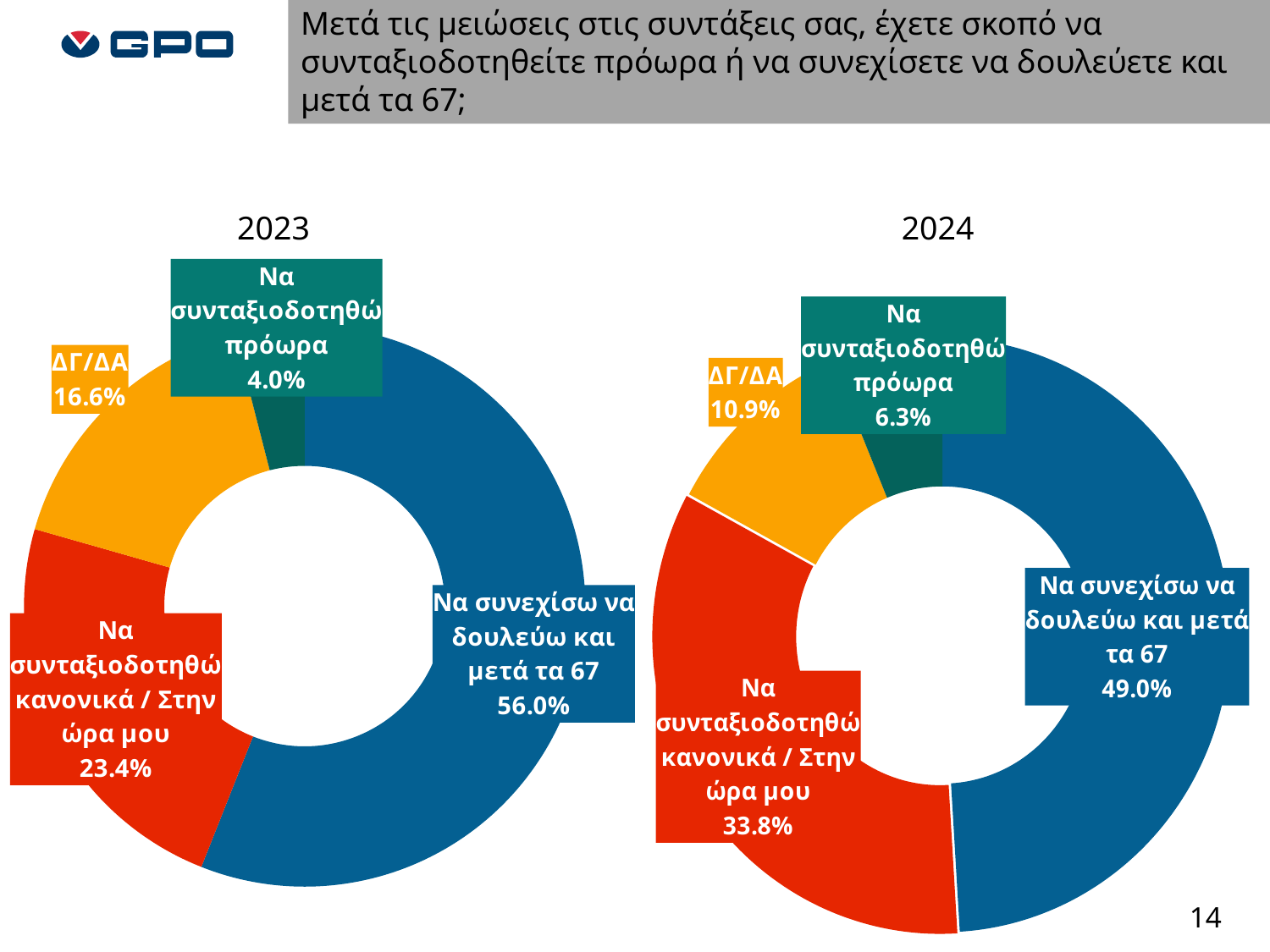
In the 2023 chart, what is the value for 'ΔΓ/ΔΑ'? 16.6% In the 2024 chart, which category has the largest share? Να συνεχίσω να δουλεύω και μετά τα 67 Which is larger: 'ΔΓ/ΔΑ' in 2023 or 'ΔΓ/ΔΑ' in 2024? 2023 In the 2023 chart, which category has the smallest share? Να συνταξιοδοτηθώ πρόωρα What type of chart is used on this slide? Doughnut chart What is the difference between the 2023 and 2024 values for 'Να συνεχίσω να δουλεύω και μετά τα 67'? 7.0% What colour is the 'Να συνταξιοδοτηθώ κανονικά / Στην ώρα μου' segment in both charts? Red In the 2023 chart, what is the value for 'Να συνεχίσω να δουλεύω και μετά τα 67'? 56.0% In the 2024 chart, what is the value for 'Να συνταξιοδοτηθώ πρόωρα'? 6.3% In the 2024 chart, what is the difference between 'Να συνταξιοδοτηθώ κανονικά / Στην ώρα μου' and 'ΔΓ/ΔΑ'? 22.9% How many categories does each doughnut chart show? 4 In the 2024 chart, what is the value for 'Να συνταξιοδοτηθώ κανονικά / Στην ώρα μου'? 33.8%